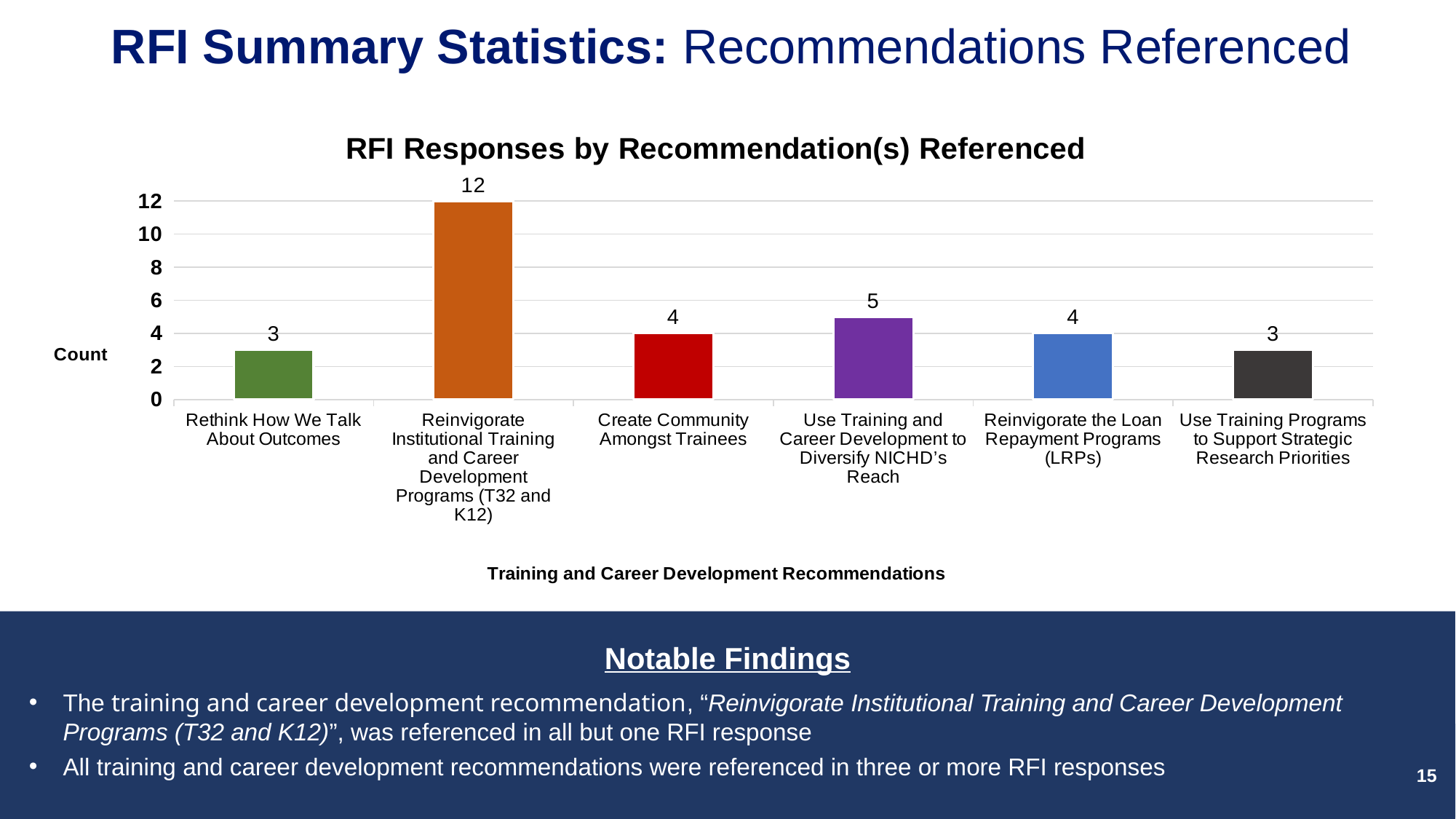
Which recommendation has the highest count? Reinvigorate Institutional Training and Career Development Programs (T32 and K12) What is the label of the vertical axis? Count What is the count for "Use Training Programs to Support Strategic Research Priorities"? 3 How many recommendation categories are shown in the chart? 6 What is the count for "Create Community Amongst Trainees"? 4 What is the count for "Use Training and Career Development to Diversify NICHD's Reach"? 5 What is the title of the chart? RFI Responses by Recommendation(s) Referenced What kind of chart is shown on the slide? bar chart Is the count for "Reinvigorate Institutional Training and Career Development Programs (T32 and K12)" greater or less than 10? greater What is the count for "Reinvigorate Institutional Training and Career Development Programs (T32 and K12)"? 12 Which has a higher count: "Use Training and Career Development to Diversify NICHD's Reach" or "Reinvigorate the Loan Repayment Programs (LRPs)"? Use Training and Career Development to Diversify NICHD's Reach What is the difference between the count for "Reinvigorate Institutional Training and Career Development Programs (T32 and K12)" and the count for "Use Training and Career Development to Diversify NICHD's Reach"? 7